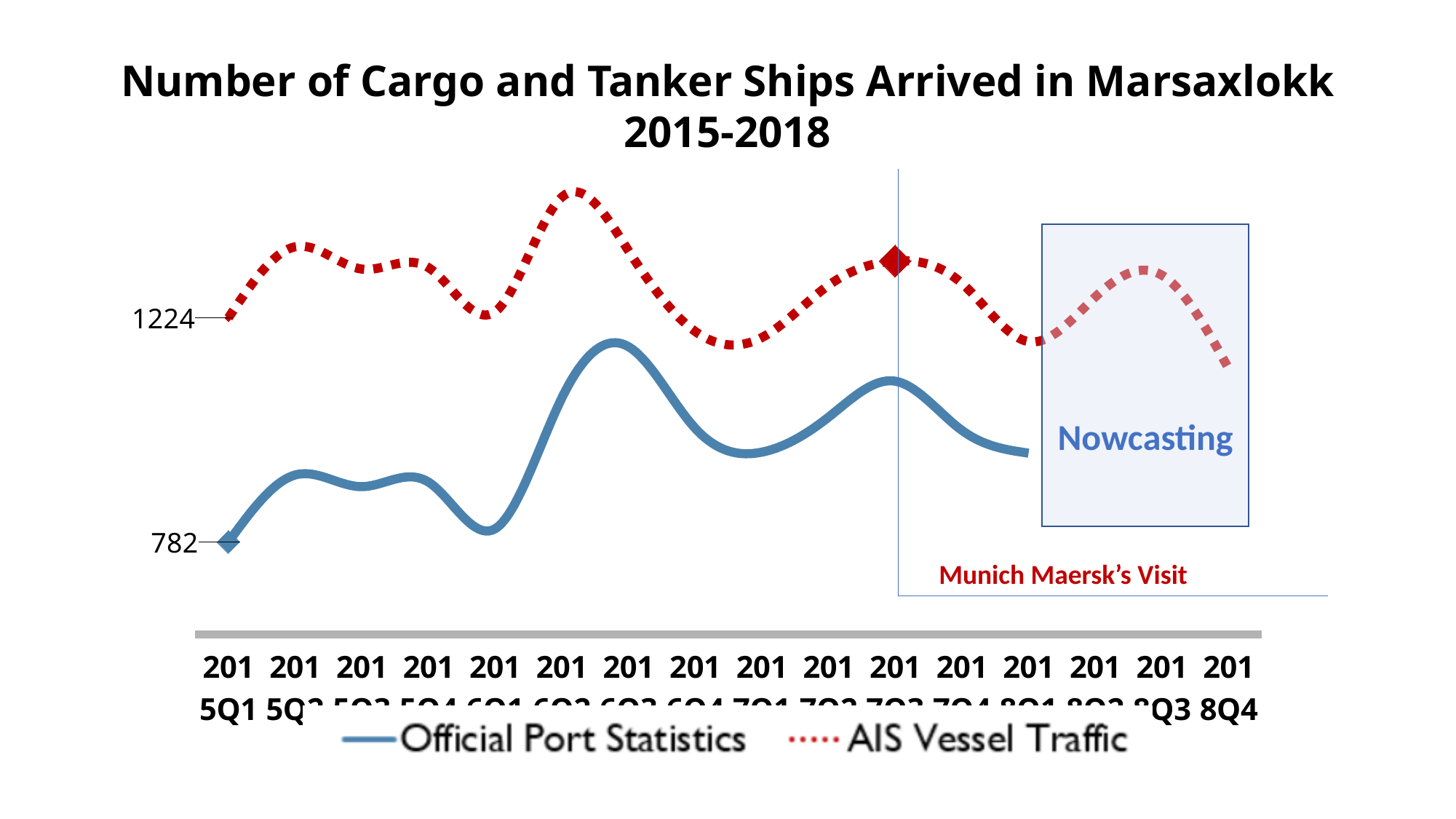
What is the title of the chart? Number of Cargo and Tanker Ships Arrived in Marsaxlokk 2015-2018 Which series lies above the other across the whole chart? AIS Vessel Traffic Does the Official Port Statistics line rise or fall from 2015Q1 to 2015Q2? Rise What is the difference between AIS Vessel Traffic and Official Port Statistics at 2015Q1? 442 Which series has the higher value at 2015Q1, AIS Vessel Traffic or Official Port Statistics? AIS Vessel Traffic What is the value of AIS Vessel Traffic at 2015Q1? 1224 How many quarterly points are shown on the x axis? 16 What label is shown in the shaded box at the right end of the chart? Nowcasting What type of chart is shown on the slide? Line chart Does the AIS Vessel Traffic line rise or fall over the last two quarters, from 2018Q3 to 2018Q4? Fall What is the value of Official Port Statistics at 2015Q1? 782 How many series does the legend list? 2